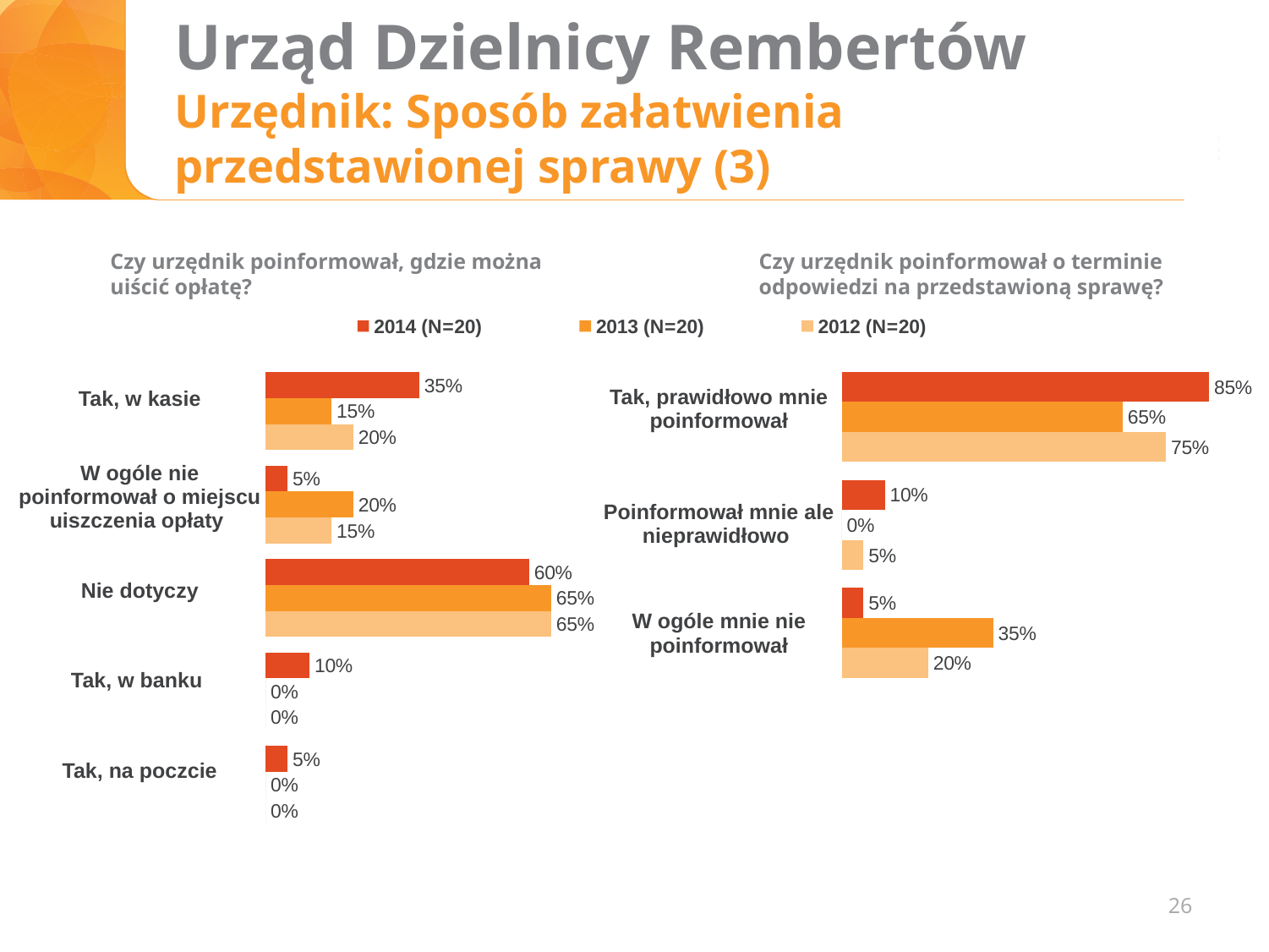
In the right chart ("Czy urzędnik poinformował o terminie odpowiedzi na przedstawioną sprawę?"), which year has the lowest value for "Tak, prawidłowo mnie poinformował"? 2013 (N=20) In the left chart ("Czy urzędnik poinformował, gdzie można uiścić opłatę?"), what is the 2014 (N=20) value for "Tak, w kasie"? 35% In the left chart ("Czy urzędnik poinformował, gdzie można uiścić opłatę?"), which category has the highest 2014 (N=20) value? Nie dotyczy In the left chart ("Czy urzędnik poinformował, gdzie można uiścić opłatę?"), how many categories are shown? 5 In the left chart ("Czy urzędnik poinformował, gdzie można uiścić opłatę?"), what is the difference between the 2014 (N=20) and 2013 (N=20) values for "Tak, w kasie"? 20 percentage points In the right chart ("Czy urzędnik poinformował o terminie odpowiedzi na przedstawioną sprawę?"), what is the 2014 (N=20) value for "Tak, prawidłowo mnie poinformował"? 85% How many series does the legend list? 3 In the left chart ("Czy urzędnik poinformował, gdzie można uiścić opłatę?"), what is the 2012 (N=20) value for "Tak, w banku"? 0% In the right chart ("Czy urzędnik poinformował o terminie odpowiedzi na przedstawioną sprawę?"), which is larger for "W ogóle mnie nie poinformował": the 2013 (N=20) value or the 2012 (N=20) value? 2013 (N=20) In the left chart ("Czy urzędnik poinformował, gdzie można uiścić opłatę?"), what is the 2013 (N=20) value for "Nie dotyczy"? 65% In the right chart ("Czy urzędnik poinformował o terminie odpowiedzi na przedstawioną sprawę?"), what is the difference between the 2013 (N=20) and 2014 (N=20) values for "W ogóle mnie nie poinformował"? 30 percentage points What kind of chart is the right chart ("Czy urzędnik poinformował o terminie odpowiedzi na przedstawioną sprawę?")? Bar chart